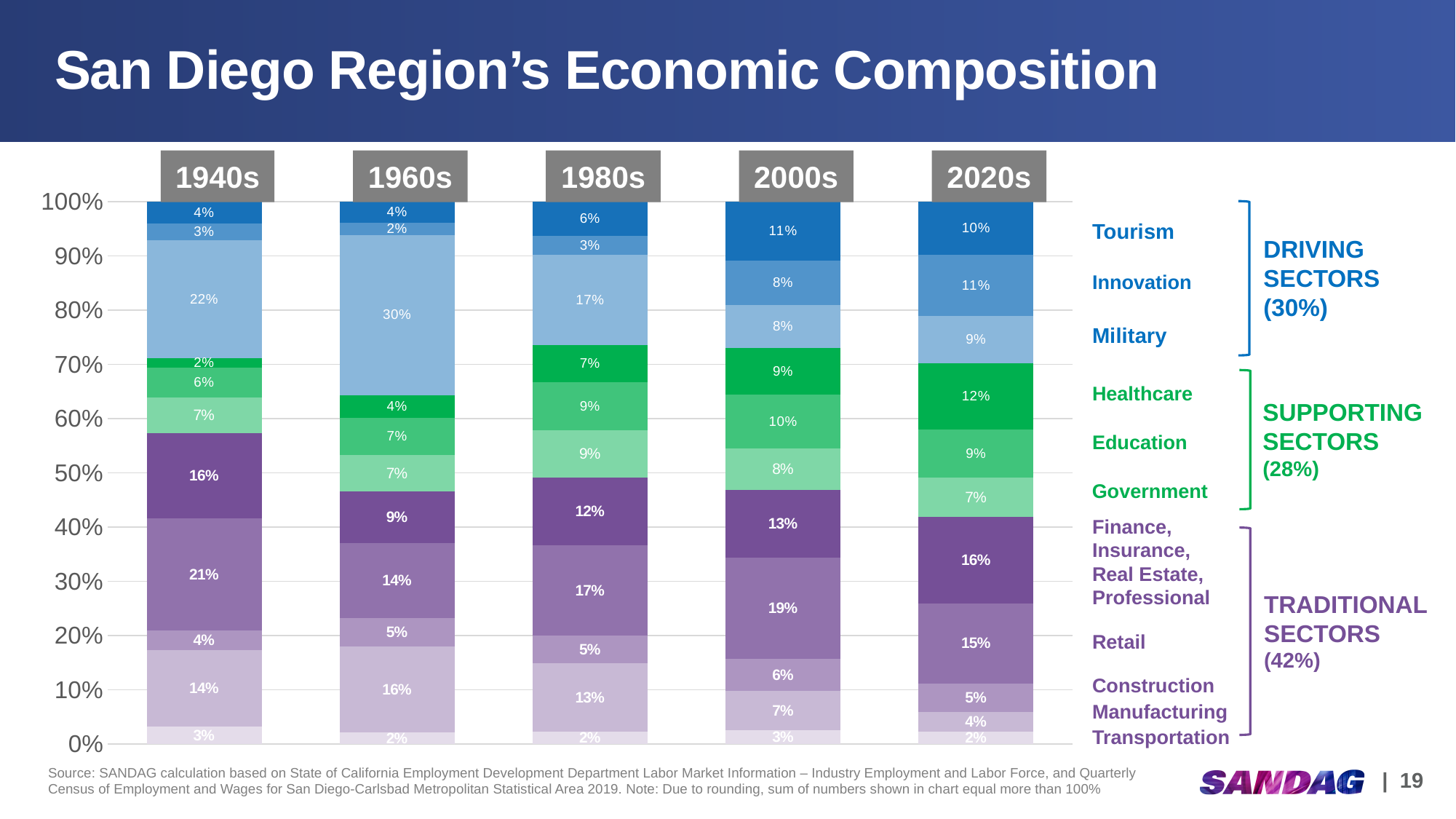
What is the Manufacturing share in the 1940s? 14% Which is larger in the 2020s, the Innovation share or the Tourism share? Innovation What kind of chart is shown on the slide? Stacked bar chart In which decade is the Tourism share the lowest? 1940s and 1960s (4%) What is the Military share in the 1960s? 30% How many sectors are listed in the legend? 11 In which decade is the Military share the highest? 1960s What is the Retail share in the 2000s? 19% Does the Healthcare share rise or fall from the 1940s to the 2020s? Rise How many decades are shown on the x axis? 5 What is the Healthcare share in the 2020s? 12% What is the difference between the Military share in the 1960s and in the 2020s? 21 percentage points